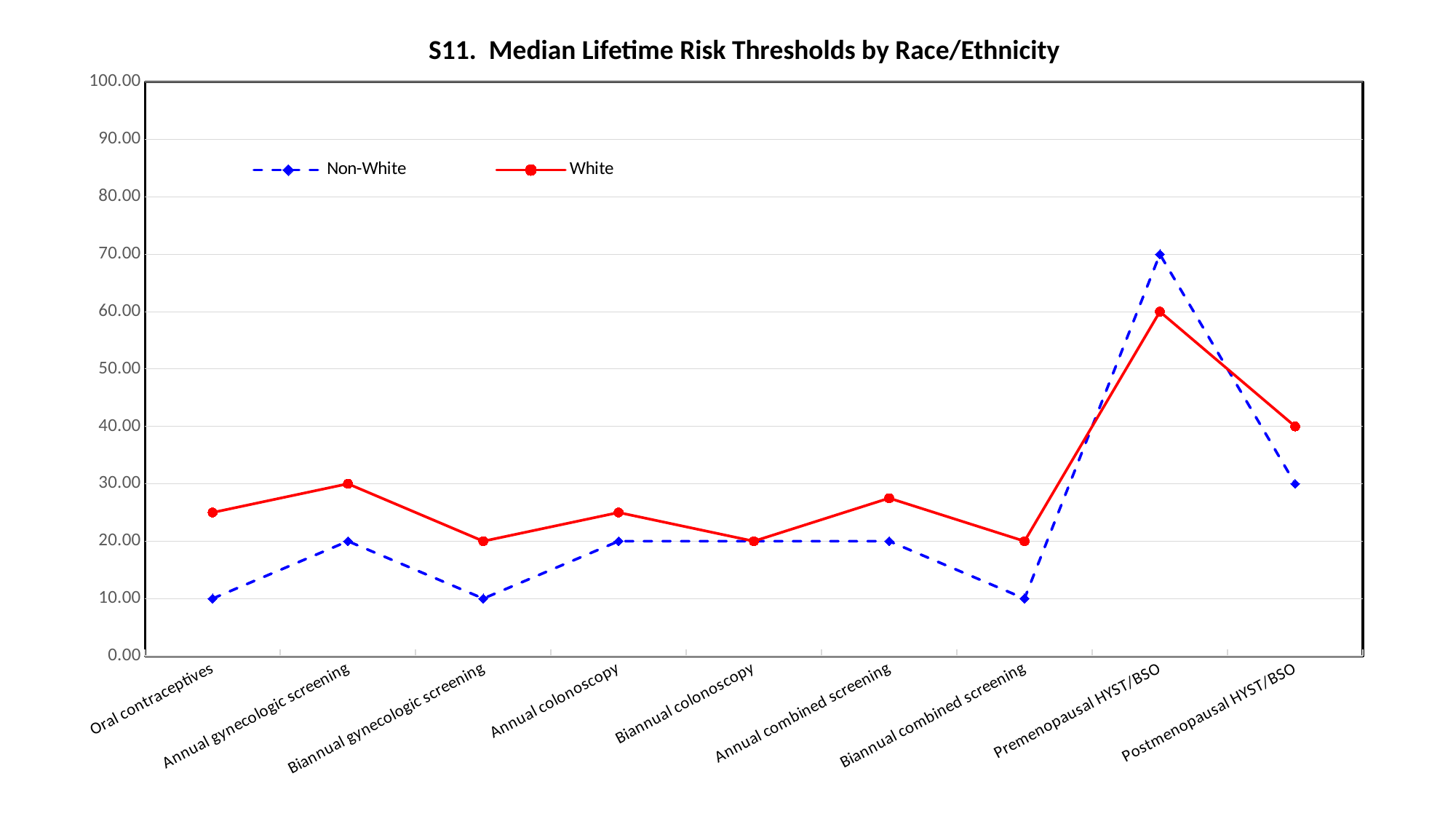
What type of chart is shown on the slide? line chart What is the difference between the Non-White and White values for Premenopausal HYST/BSO? 10.00 What is the White value for Annual gynecologic screening? 30.00 Is the White value for Oral contraceptives greater or less than 20.00? greater What is the White value for Postmenopausal HYST/BSO? 40.00 How many categories are shown on the x axis? 9 For Postmenopausal HYST/BSO, which series has the larger value, Non-White or White? White How many series does the legend list? 2 Which category has the lowest White value among Biannual gynecologic screening and Annual gynecologic screening? Biannual gynecologic screening What is the Non-White value for Premenopausal HYST/BSO? 70.00 What is the Non-White value for Oral contraceptives? 10.00 Which category has the highest Non-White value? Premenopausal HYST/BSO